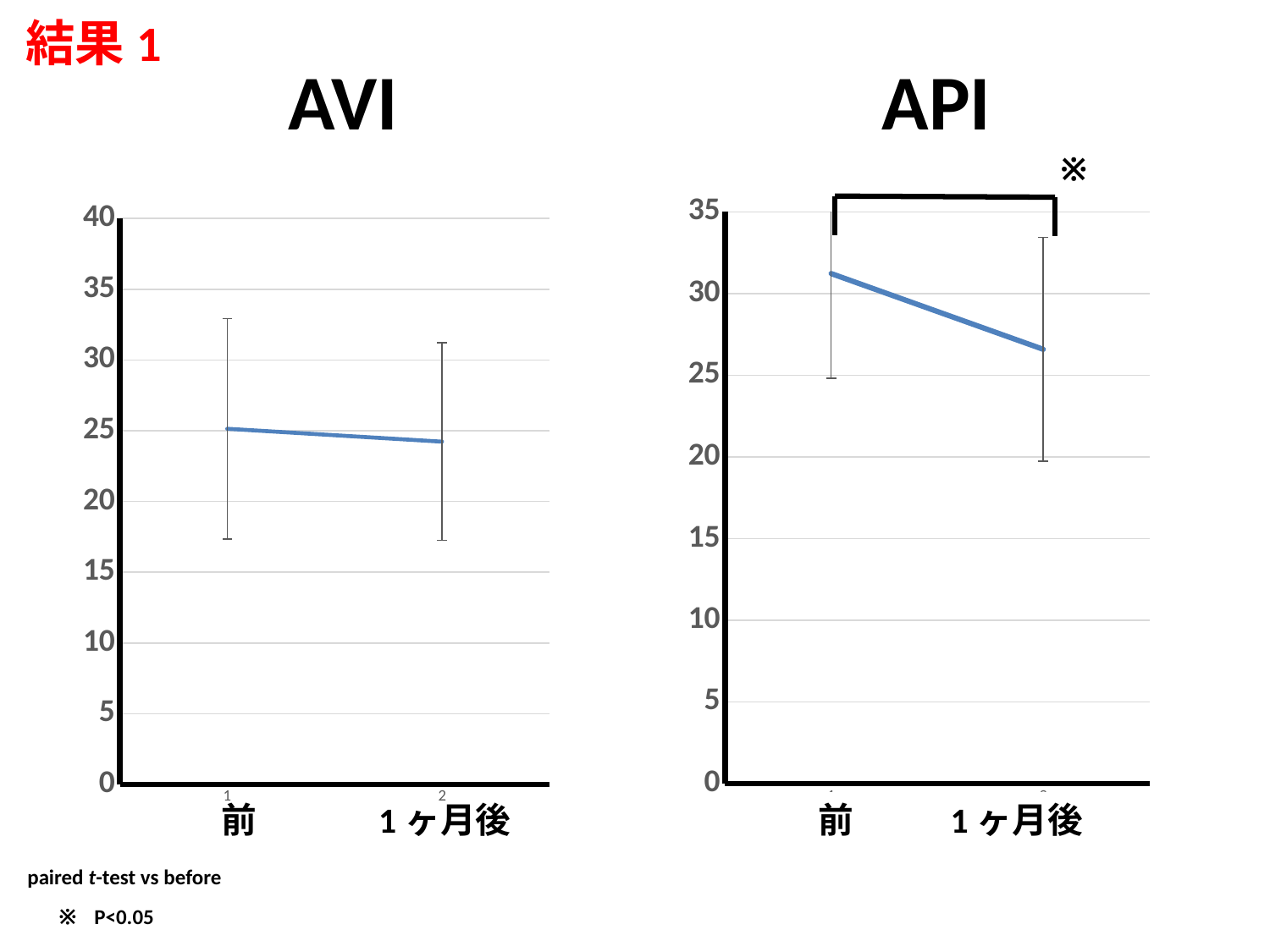
In the API chart, do the values rise or fall from 前 to 1ヶ月後? fall In the API chart, which time point has the higher value, 前 or 1ヶ月後? 前 What are the two x-axis labels on the API chart? 前 and 1ヶ月後 In the API chart, is the value for 1ヶ月後 greater or less than 25? greater How many time points are plotted on the API chart? 2 How many time points are plotted on the AVI chart? 2 What kind of chart is the API chart? line chart In the AVI chart, is the value for 1ヶ月後 greater or less than 30? less In the API chart, is the value for 前 greater or less than 30? greater What kind of chart is the AVI chart? line chart